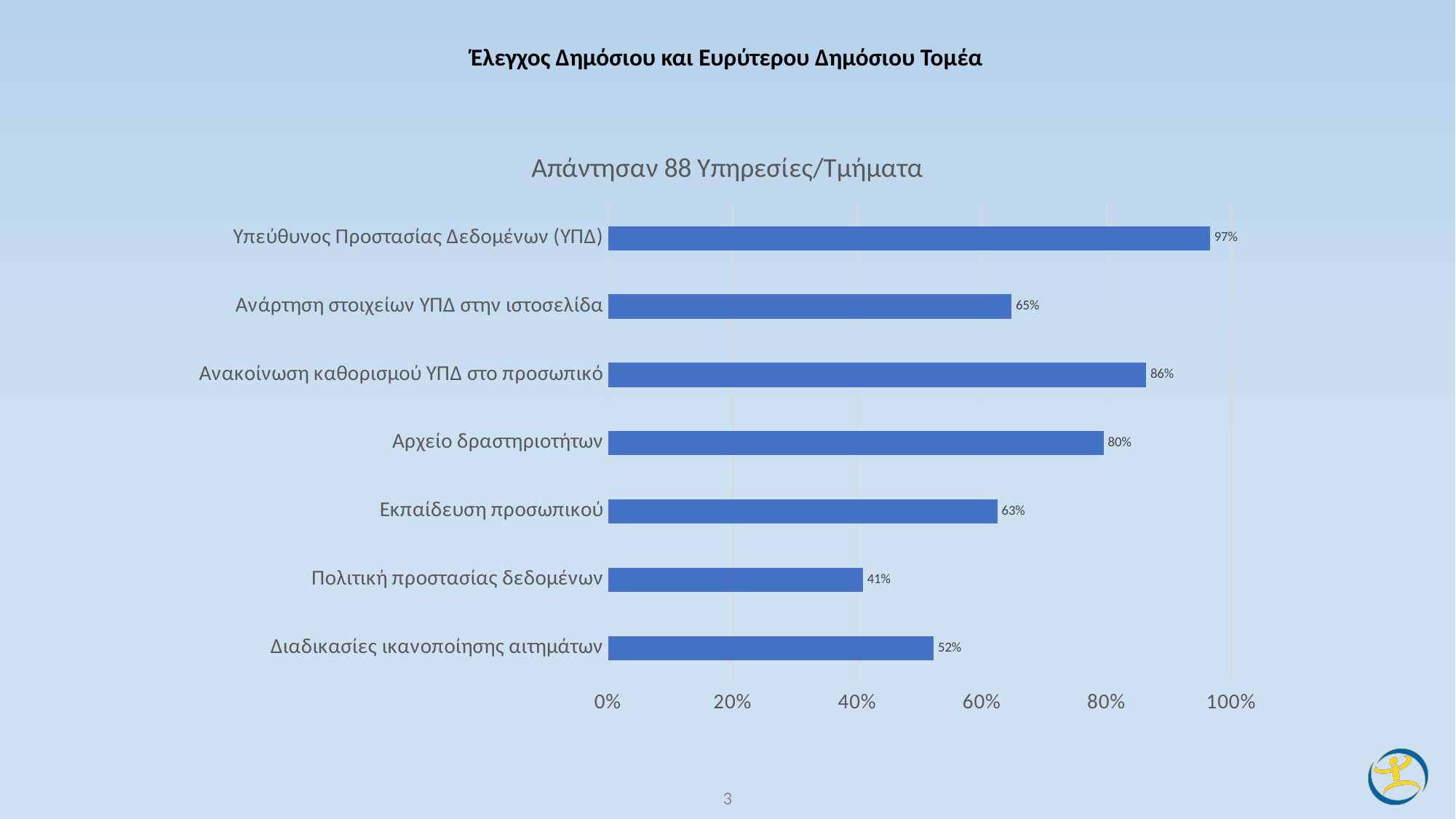
Which is larger, the value for Ανάρτηση στοιχείων ΥΠΔ στην ιστοσελίδα or the value for Εκπαίδευση προσωπικού? Ανάρτηση στοιχείων ΥΠΔ στην ιστοσελίδα What is the title of the chart? Απάντησαν 88 Υπηρεσίες/Τμήματα What is the value for Διαδικασίες ικανοποίησης αιτημάτων? 52% What is the maximum value shown on the x axis? 100% What is the difference between the values for Ανακοίνωση καθορισμού ΥΠΔ στο προσωπικό and Αρχείο δραστηριοτήτων? 6% What is the value for Εκπαίδευση προσωπικού? 63% How many categories are shown in the chart? 7 What kind of chart is shown on the slide? bar chart Is the value for Πολιτική προστασίας δεδομένων greater or less than 60%? less Which category has the highest value? Υπεύθυνος Προστασίας Δεδομένων (ΥΠΔ) Which category has the lowest value? Πολιτική προστασίας δεδομένων What is the value for Υπεύθυνος Προστασίας Δεδομένων (ΥΠΔ)? 97%